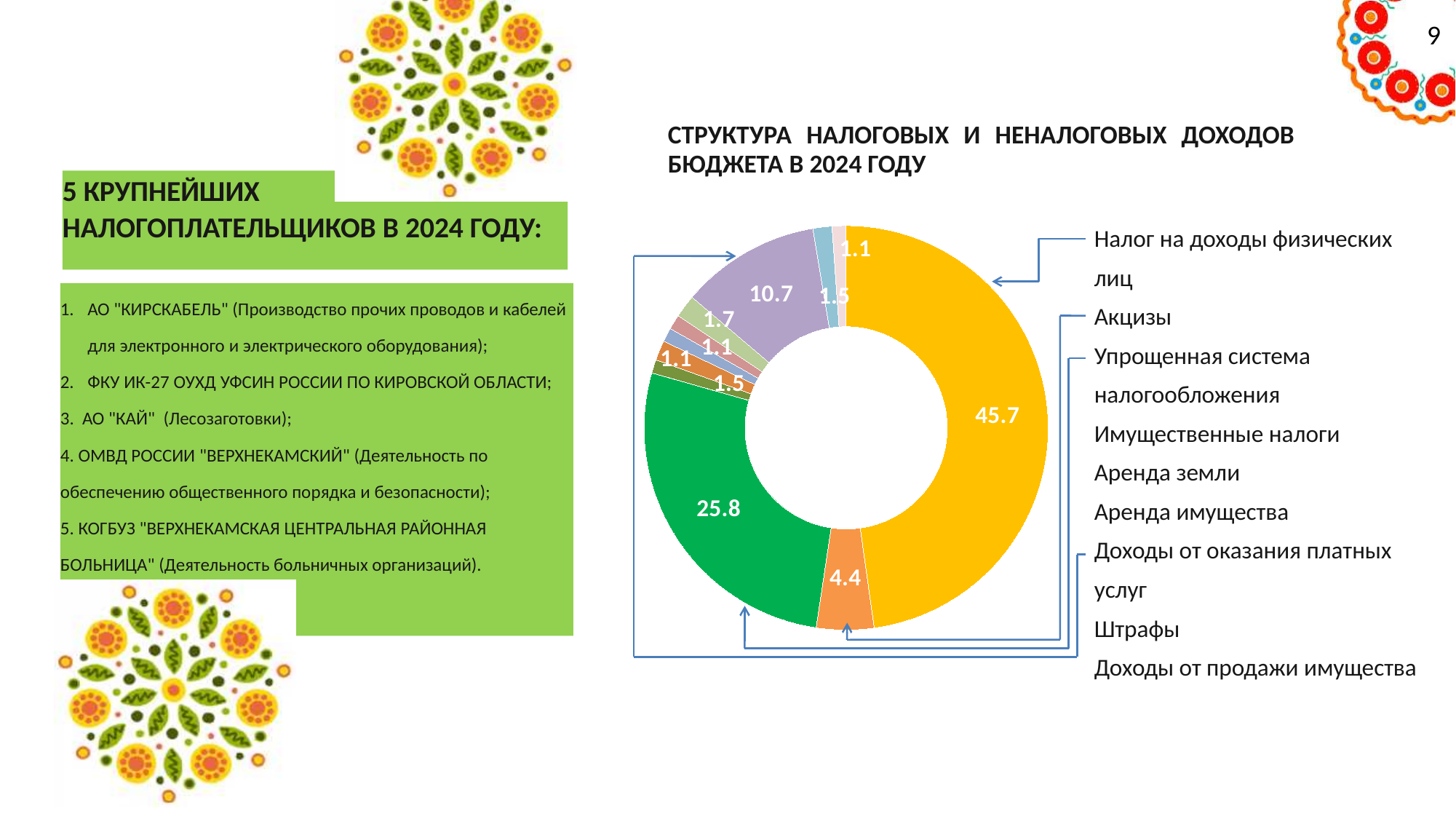
Which is larger, the green slice or the purple slice? the green slice What is the difference between the yellow slice (45.7) and the green slice (25.8)? 19.9 What is the value labelled on the purple slice? 10.7 Which category has the largest slice of the pie? Налог на доходы физических лиц What is the value labelled on the green slice? 25.8 What is the value shown for Налог на доходы физических лиц? 45.7 What is the smallest value labelled on the pie chart? 1.1 How many entries does the chart legend list? 9 What kind of chart is shown on the slide? doughnut chart What is the difference between the yellow slice (45.7) and the purple slice (10.7)? 35 What is the largest value labelled on the pie chart? 45.7 What is the title of the chart? СТРУКТУРА НАЛОГОВЫХ И НЕНАЛОГОВЫХ ДОХОДОВ БЮДЖЕТА В 2024 ГОДУ